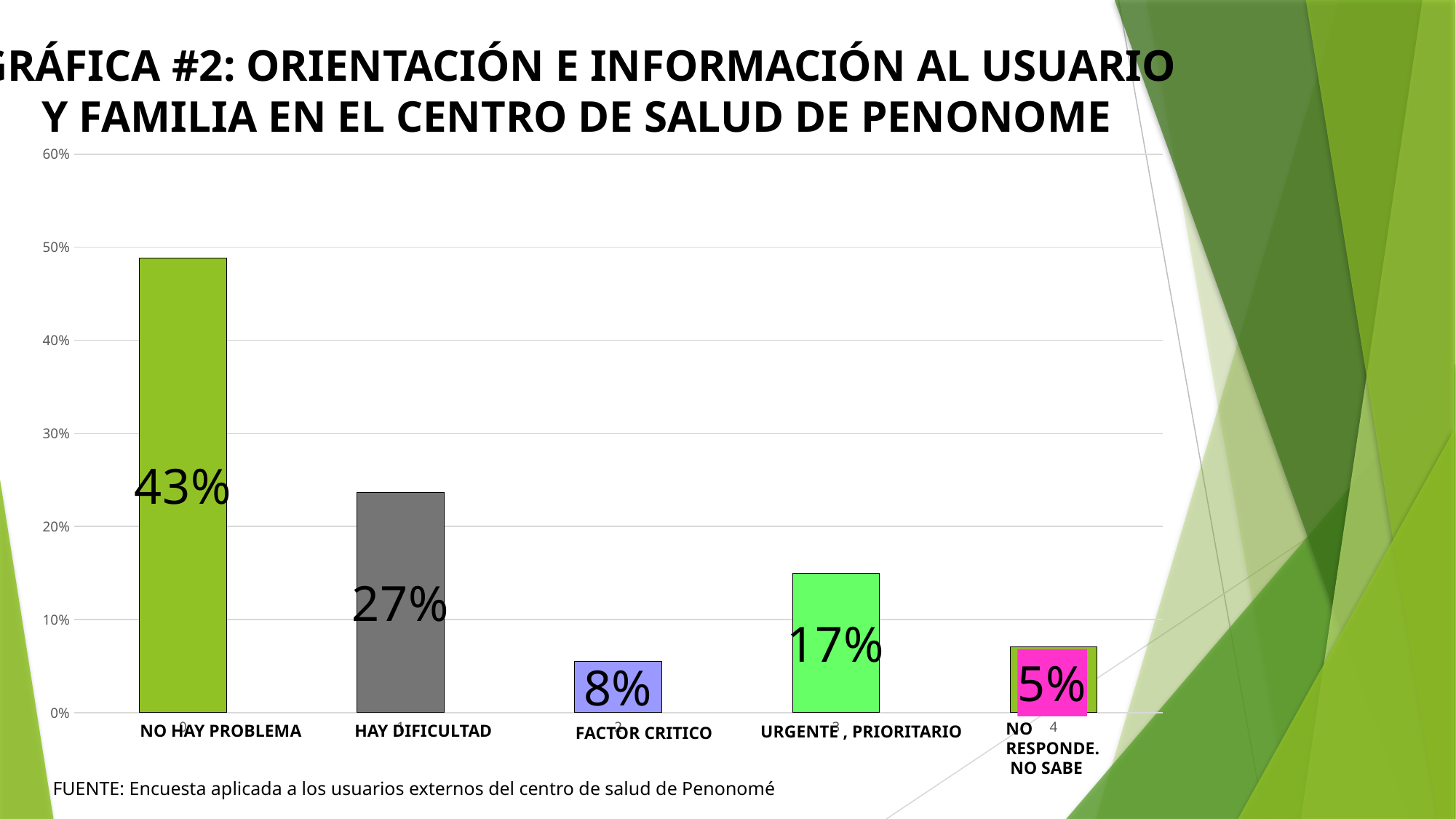
What is the difference between the values for NO HAY PROBLEMA and HAY DIFICULTAD? 16% What is the value for HAY DIFICULTAD? 27% What is the value for NO HAY PROBLEMA? 43% Which is larger, the value for URGENTE, PRIORITARIO or the value for FACTOR CRITICO? URGENTE, PRIORITARIO What is the value for URGENTE, PRIORITARIO? 17% What kind of chart is shown on the slide? bar chart What is the value for FACTOR CRITICO? 8% What is the value for NO RESPONDE. NO SABE? 5% Which category has the highest value? NO HAY PROBLEMA How many categories are shown in the chart? 5 Is the value for NO HAY PROBLEMA greater or less than 40%? greater